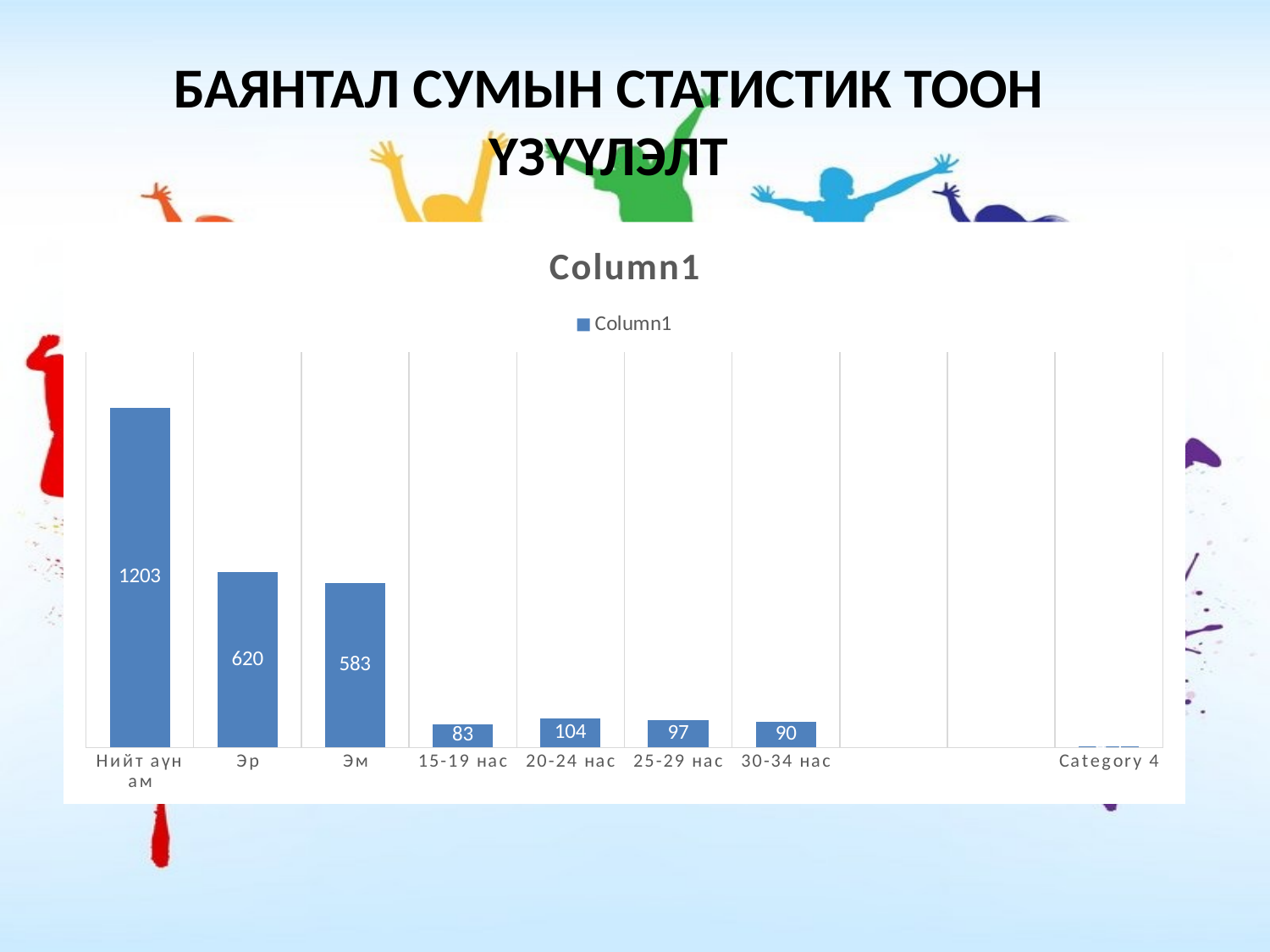
Which of the age groups 15-19 нас, 20-24 нас, 25-29 нас and 30-34 нас has the lowest value? 15-19 нас What kind of chart is shown on the slide? Bar chart What is the value for Нийт аүн ам? 1203 Which is larger, the value for 25-29 нас or the value for 30-34 нас? 25-29 нас What is the difference between the values for Эр and Эм? 37 What is the difference between the values for 20-24 нас and 15-19 нас? 21 What is the value for 20-24 нас? 104 What is the value for 30-34 нас? 90 Which category has the highest value? Нийт аүн ам What is the value for Эр? 620 What is the value for Эм? 583 How many series does the legend list? 1